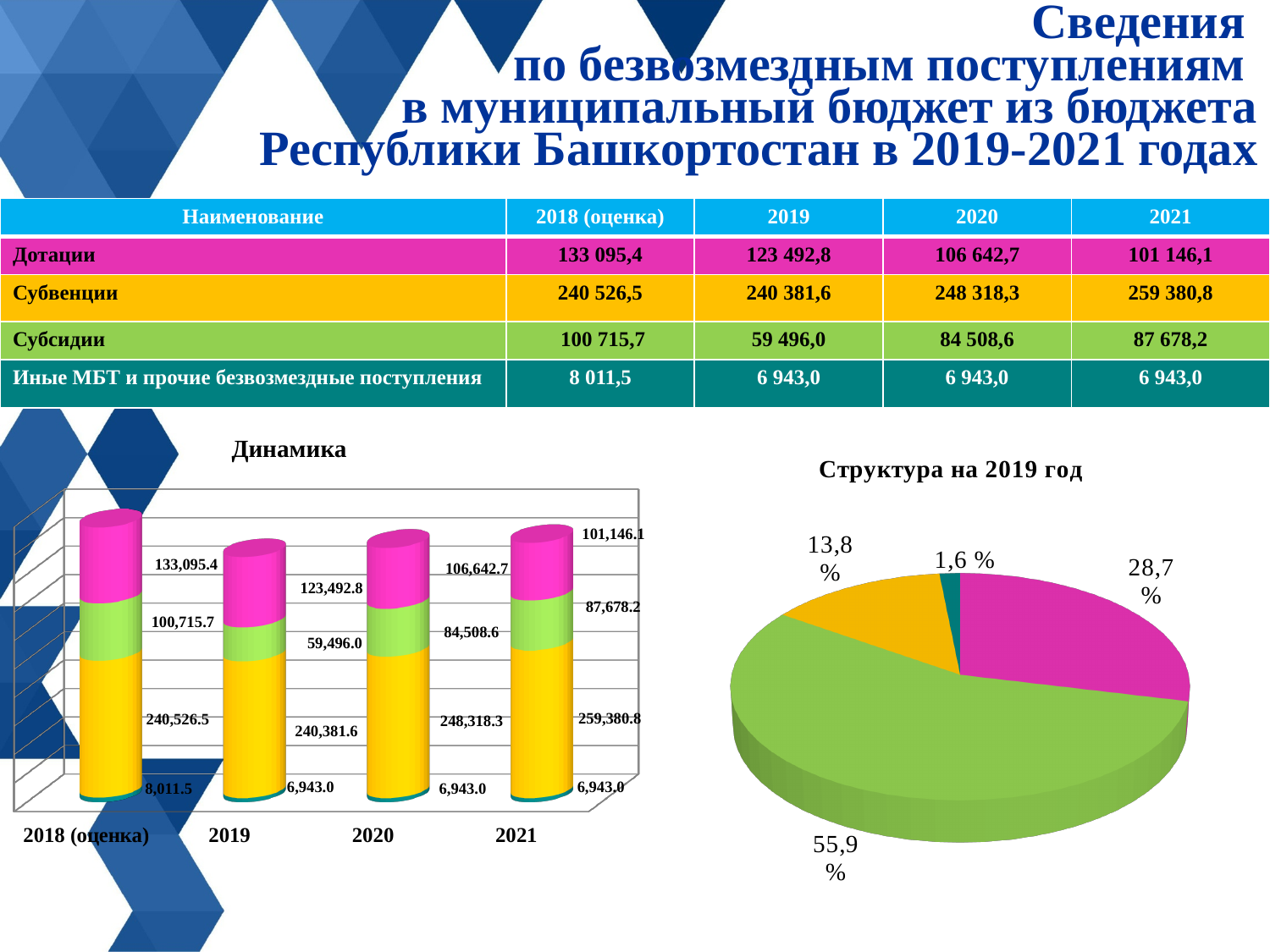
What kind of chart is the "Структура на 2019 год" chart? pie chart In the "Динамика" chart, what is the total of the stacked bar for 2019? 430,313.4 In the "Динамика" chart, do the values of the pink (top) segment rise or fall from 2018 (оценка) to 2021? fall In the "Динамика" chart, which year has the largest yellow segment? 2021 In the "Структура на 2019 год" chart, what share does the largest (green) slice have? 55,9 % What kind of chart is the "Динамика" chart? bar chart In the "Динамика" chart, what is the difference between the yellow segment values for 2021 and 2020? 11,062.5 In the "Динамика" chart, what is the value of the bottom segment for 2018 (оценка)? 8,011.5 In the "Динамика" chart, what is the value of the yellow segment for 2021? 259,380.8 In the "Динамика" chart, what is the value of the pink (top) segment for 2019? 123,492.8 In the "Структура на 2019 год" chart, how many slices does the pie have? 4 In the "Динамика" chart, how many years are shown on the x axis? 4